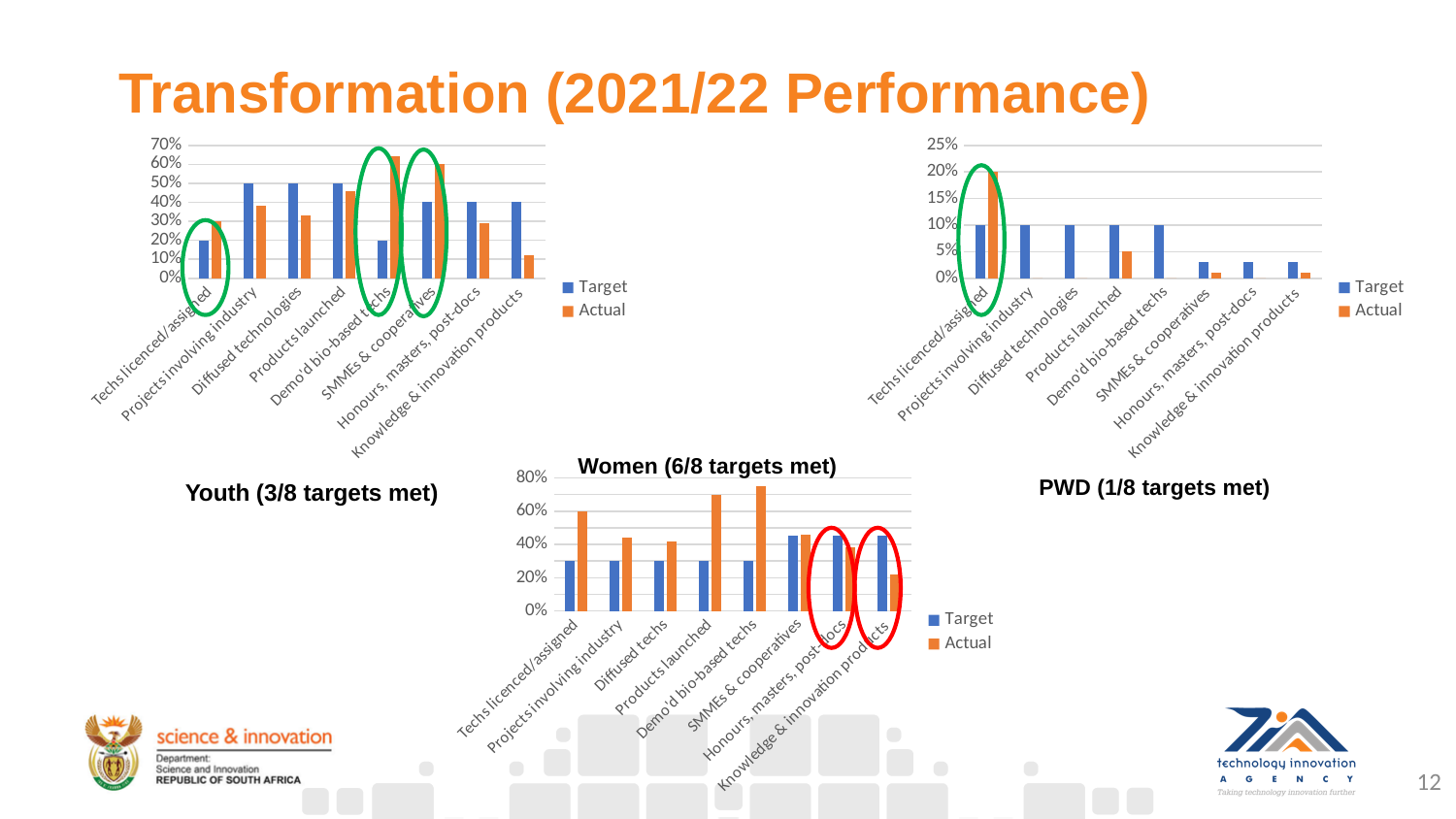
In the Women (6/8 targets met) chart, is the Actual value for Demo'd bio-based techs greater or less than 60%? greater In the Women (6/8 targets met) chart, which category has the lowest Actual value? Knowledge & innovation products In the PWD (1/8 targets met) chart, is the Actual value for Products launched greater or less than 10%? less How many series does the legend of the Women (6/8 targets met) chart list? 2 What kind of chart is the Youth (3/8 targets met) chart? bar chart How many charts are on the slide? 3 Which colour represents the Actual series in the charts on the slide? orange In the PWD (1/8 targets met) chart, what is the Actual value for Techs licenced/assigned? 20% In the Youth (3/8 targets met) chart, which is larger for Knowledge & innovation products, the Target or the Actual value? Target In the Youth (3/8 targets met) chart, what is the Target value for Projects involving industry? 50% In the Youth (3/8 targets met) chart, which category has the highest Actual value? Demo'd bio-based techs How many categories are shown on the x axis of the PWD (1/8 targets met) chart? 8